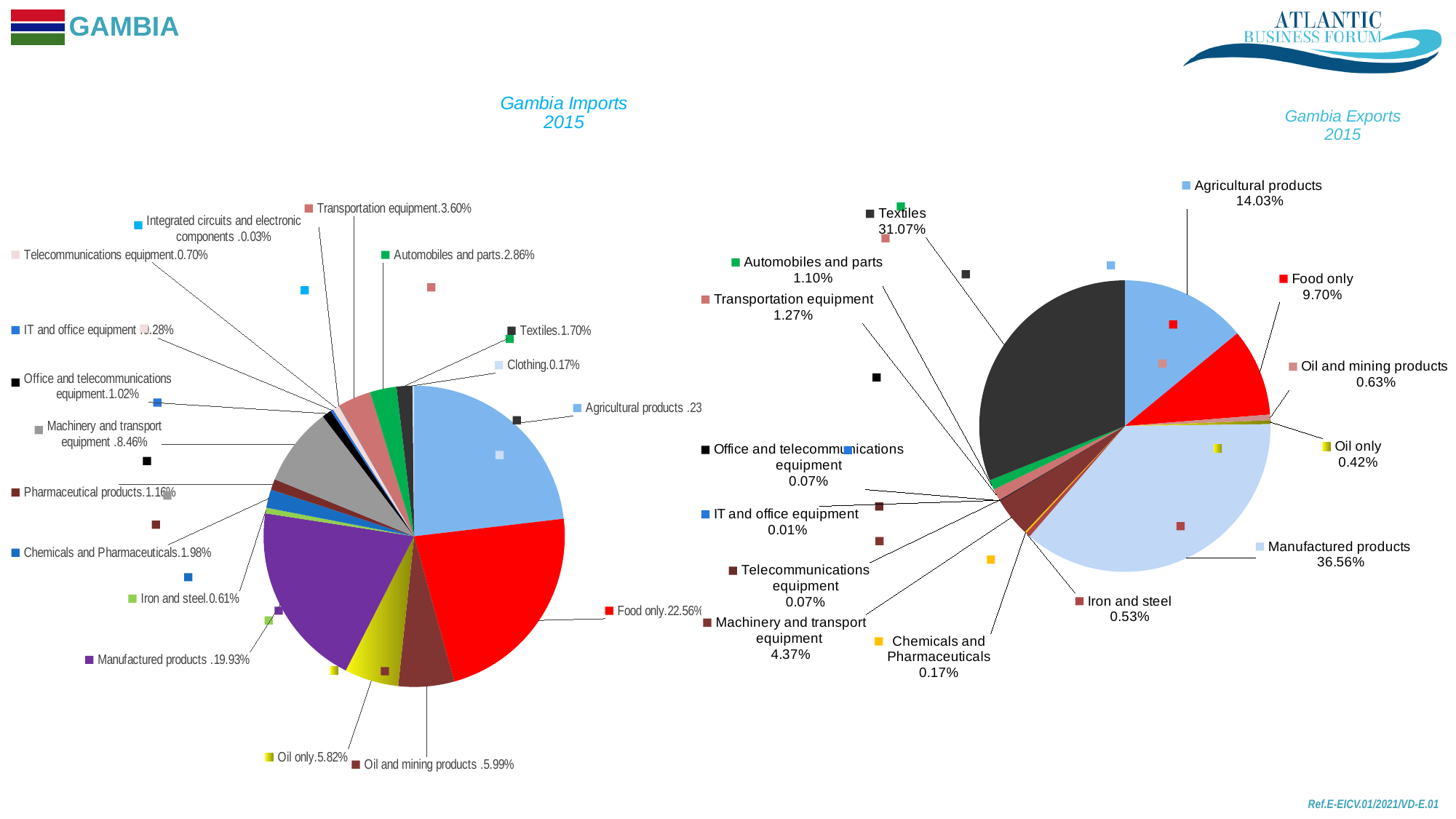
How many categories are shown in the Gambia Exports 2015 chart? 14 In the Gambia Imports 2015 chart, what share is Manufactured products? 19.93% In the Gambia Exports 2015 chart, which category has the smallest share? IT and office equipment In the Gambia Exports 2015 chart, which is larger: Agricultural products or Food only? Agricultural products In the Gambia Imports 2015 chart, what share is Machinery and transport equipment? 8.46% In the Gambia Exports 2015 chart, which category has the largest share? Manufactured products What type of chart is the Gambia Imports 2015 chart? Pie chart In the Gambia Imports 2015 chart, what share is Food only? 22.56% In the Gambia Exports 2015 chart, what is the difference between Manufactured products and Textiles? 5.49% In the Gambia Imports 2015 chart, which is larger: Oil only or Oil and mining products? Oil and mining products In the Gambia Exports 2015 chart, what share is Manufactured products? 36.56% In the Gambia Exports 2015 chart, what share is Textiles? 31.07%